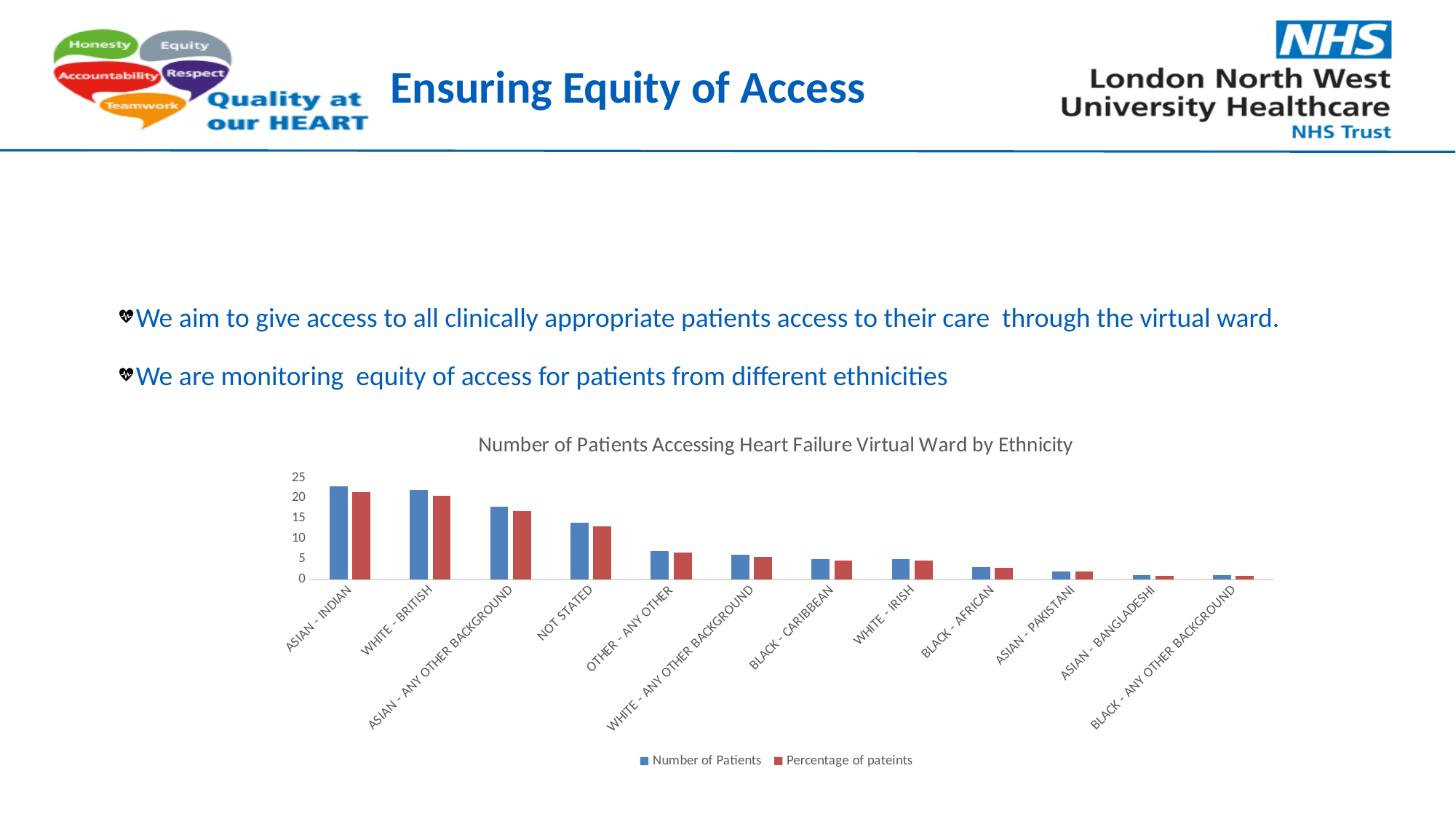
What is the title of the chart? Number of Patients Accessing Heart Failure Virtual Ward by Ethnicity What type of chart is shown on the slide? Bar chart Which colour represents the Number of Patients series in the chart? Blue Is the Number of Patients for NOT STATED greater or less than 10? greater How many series does the chart legend list? 2 How many ethnicity categories are shown on the x axis of the chart? 12 Which ethnicity category has the highest Number of Patients? ASIAN - INDIAN Is the Number of Patients for ASIAN - ANY OTHER BACKGROUND greater or less than 15? greater Is the Number of Patients for BLACK - AFRICAN greater or less than 5? less Which has a larger Number of Patients, WHITE - BRITISH or NOT STATED? WHITE - BRITISH Do the Number of Patients values generally rise or fall moving left to right along the x axis? fall